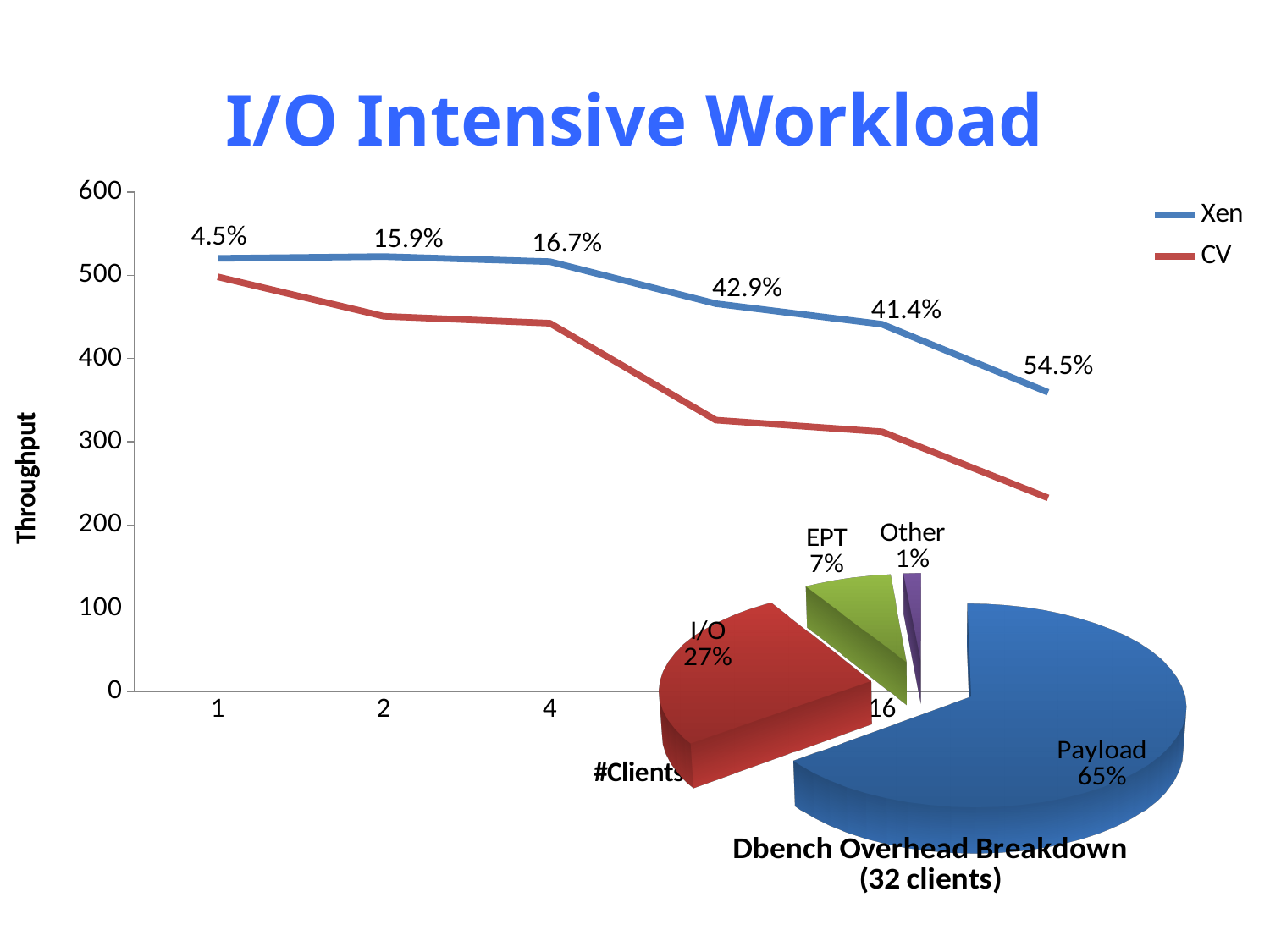
In the Throughput line chart, what percentage label is printed above the last data point on the right? 54.5% What type of chart is the upper chart with the Throughput axis? line chart In the Throughput line chart, what percentage label is printed above the first data point at 1 client? 4.5% In the Throughput line chart, which series has the higher throughput at 4 clients, Xen or CV? Xen In the Throughput line chart, do the Xen and CV values rise or fall as the number of clients increases? fall In the Throughput line chart, is the Xen value at 1 client greater or less than 500? greater What type of chart is the 'Dbench Overhead Breakdown (32 clients)' chart? pie chart In the 'Dbench Overhead Breakdown (32 clients)' pie chart, what share does Payload have? 65% In the 'Dbench Overhead Breakdown (32 clients)' pie chart, what is the difference between the Payload share and the I/O share? 38% In the 'Dbench Overhead Breakdown (32 clients)' pie chart, which slice is the smallest? Other How many series does the legend of the Throughput line chart list? 2 In the Throughput line chart, is the CV value at 4 clients greater or less than 400? greater